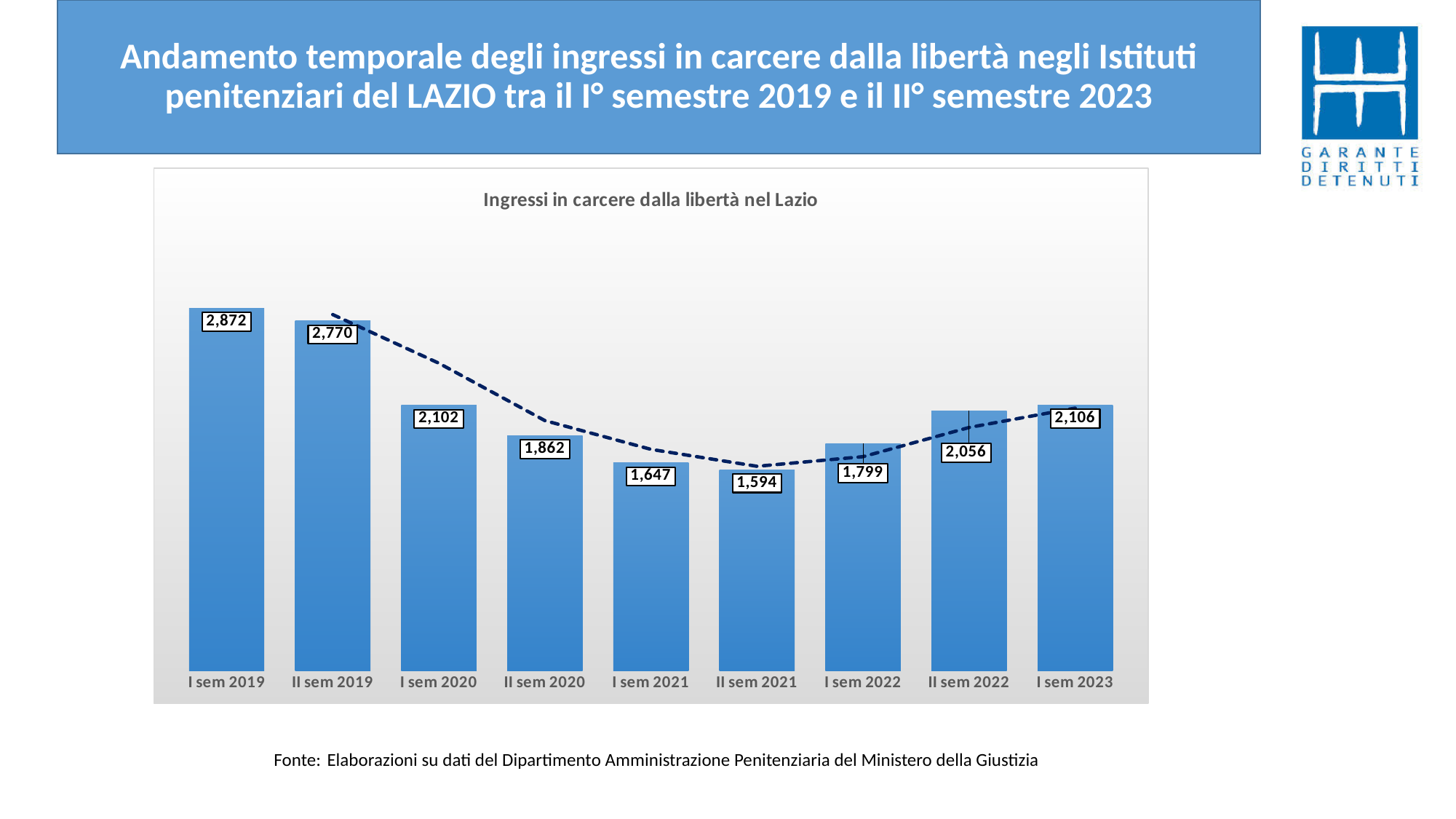
What is the title of the chart? Ingressi in carcere dalla libertà nel Lazio What is the value for I sem 2023? 2,106 What is the difference between the values for I sem 2023 and II sem 2021? 512 What is the value for II sem 2021? 1,594 What is the difference between the values for I sem 2019 and II sem 2019? 102 What kind of chart is this? Bar chart How many periods are shown on the x axis? 9 Which period has the highest value? I sem 2019 Which is larger, the value for I sem 2020 or the value for II sem 2020? I sem 2020 What is the value for I sem 2019? 2,872 What is the value for II sem 2022? 2,056 Which period has the lowest value? II sem 2021